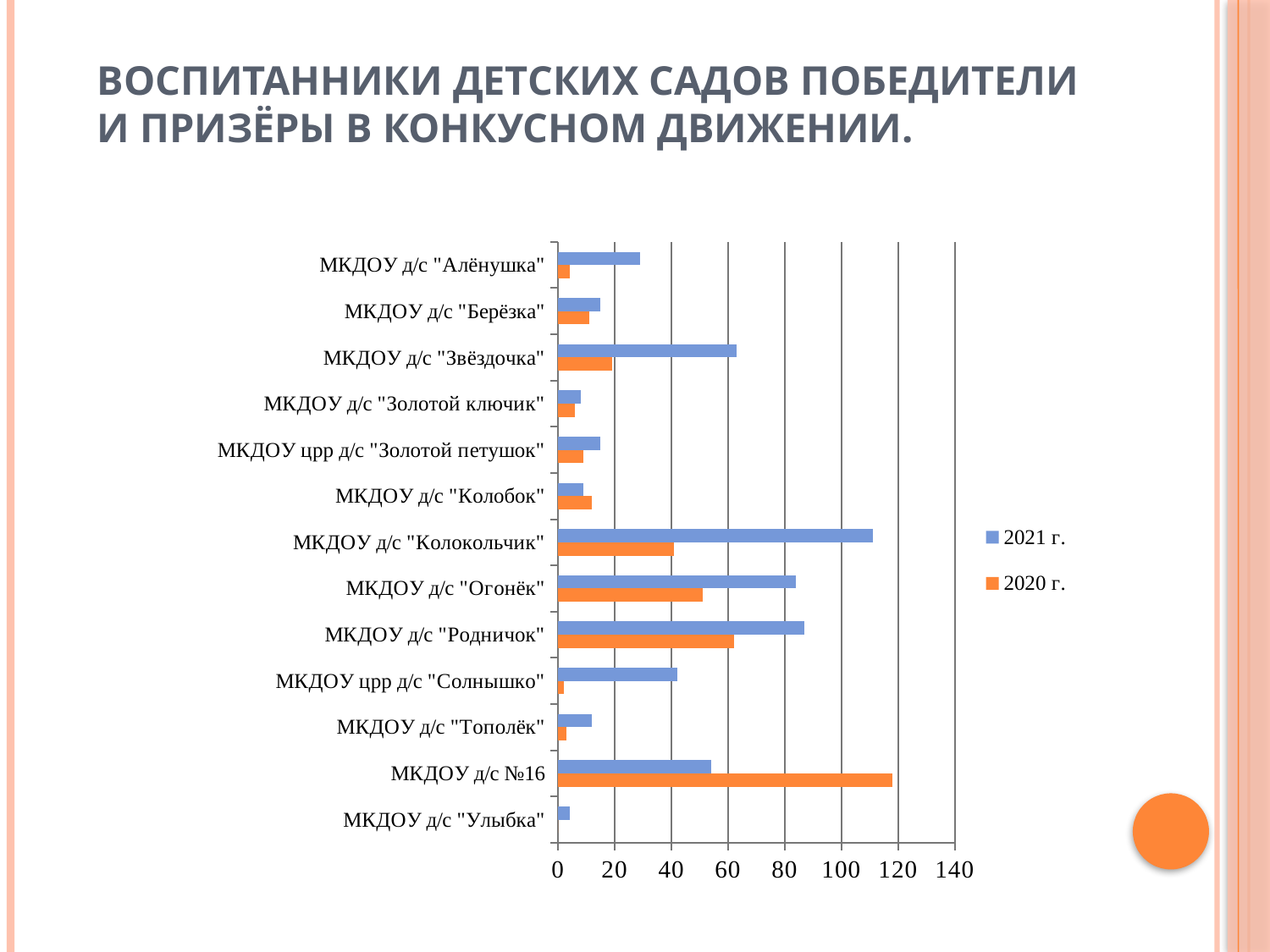
For МКДОУ д/с "Огонёк", which year has the larger value, 2021 г. or 2020 г.? 2021 г. How many kindergartens (categories) are listed on the chart? 13 For МКДОУ д/с №16, which year has the larger value, 2021 г. or 2020 г.? 2020 г. How many series does the legend list? 2 Is the 2020 г. value for МКДОУ д/с №16 greater or less than 100? greater Which kindergarten has the highest value for 2020 г.? МКДОУ д/с №16 Which series are listed in the legend? 2021 г. and 2020 г. Is the 2020 г. value for МКДОУ црр д/с "Солнышко" greater or less than 20? less What kind of chart is shown on the slide? bar chart Is the 2021 г. value for МКДОУ д/с "Колокольчик" greater or less than 100? greater Which kindergarten has the highest value for 2021 г.? МКДОУ д/с "Колокольчик"